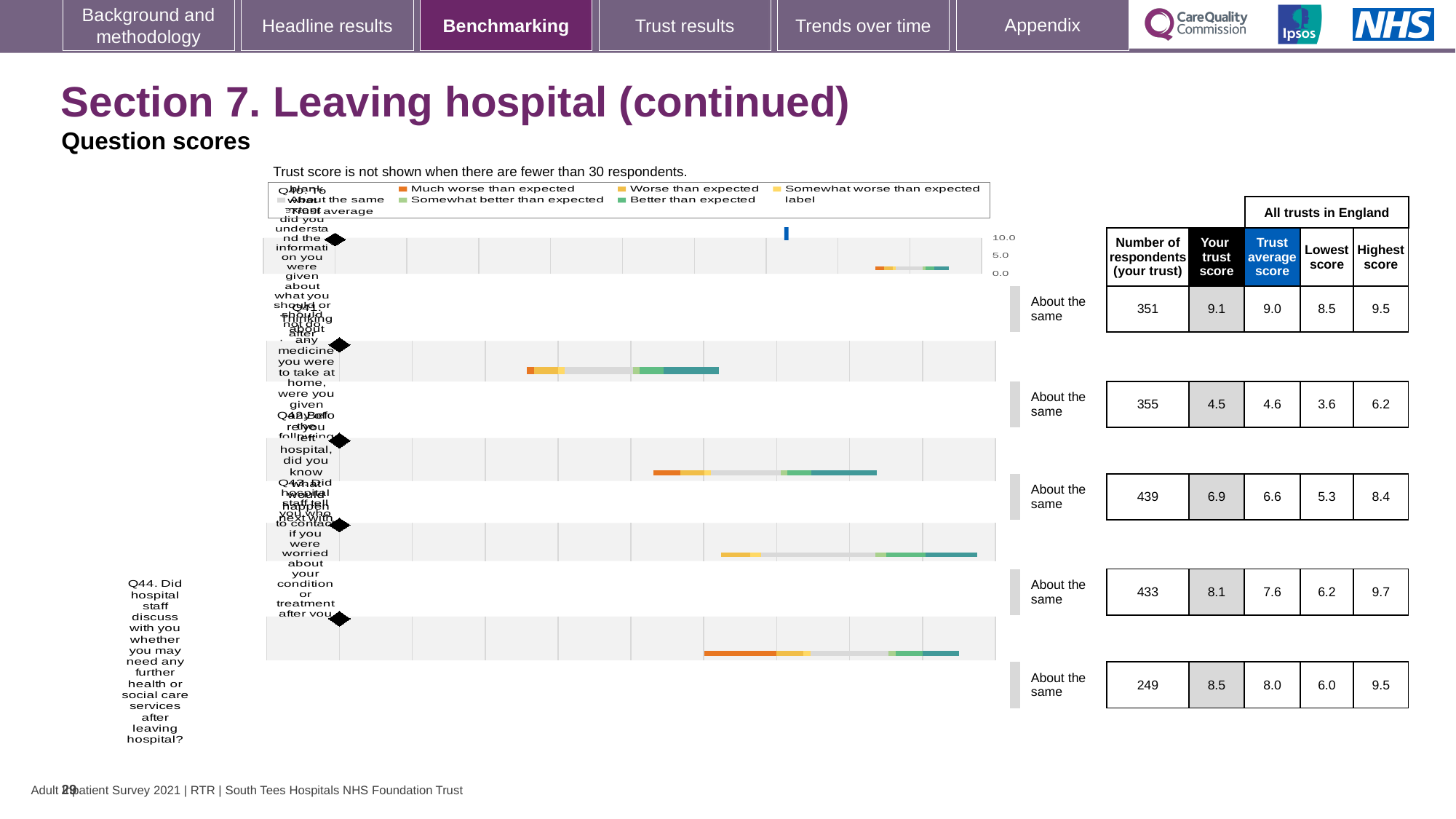
What benchmark category is shown for every question on this slide? About the same For Q44, which is larger: the trust's own score or the trust average score? Your trust score What is the highest score among all trusts in England for Q44? 9.5 How many questions (rows) are shown in the benchmarking chart on this slide? 5 What is the trust average score across all trusts in England for Q44? 8.0 For Q44, what is the difference between the trust's own score and the trust average score? 0.5 How many respondents from the trust answered Q44? 249 What is the lowest score among all trusts in England for Q44? 6.0 What is the 'Your trust score' for Q44 (Did hospital staff discuss with you whether you may need any further health or social care services after leaving hospital?)? 8.5 What is the lowest 'Your trust score' value shown in the table on this slide? 4.5 What kind of chart is used to show the question scores on this slide? Bar chart What is the highest 'Your trust score' value shown in the table on this slide? 9.1